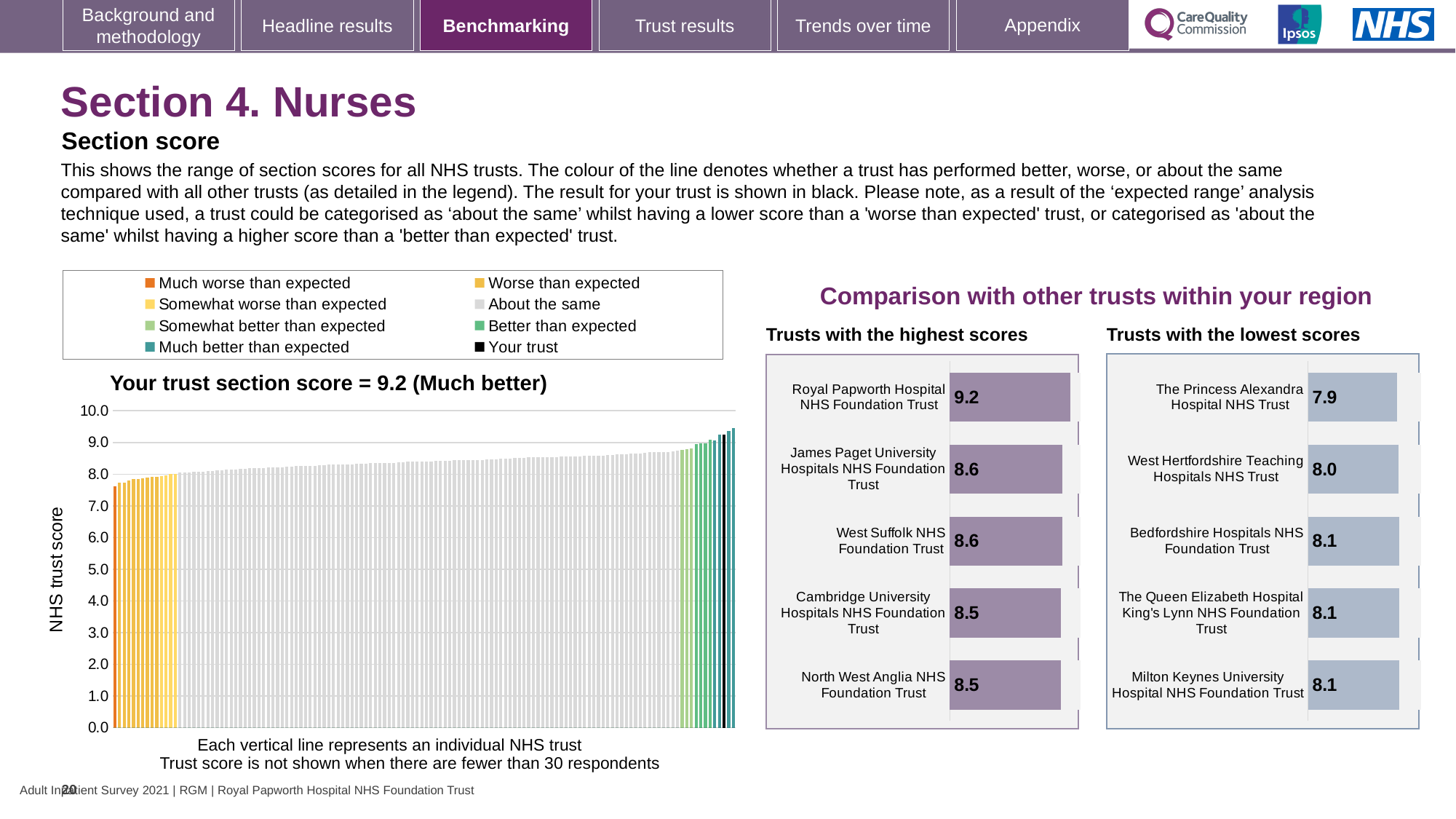
In the 'Trusts with the highest scores' chart, which has the larger score: James Paget University Hospitals NHS Foundation Trust or Cambridge University Hospitals NHS Foundation Trust? James Paget University Hospitals NHS Foundation Trust In the 'Trusts with the highest scores' chart, what is the score for Royal Papworth Hospital NHS Foundation Trust? 9.2 How many trusts are shown in the 'Trusts with the highest scores' chart? 5 In the 'Trusts with the lowest scores' chart, what is the score for The Princess Alexandra Hospital NHS Trust? 7.9 How many entries does the legend of the main chart on the left list? 8 In the 'Trusts with the highest scores' chart, which trust has the highest score? Royal Papworth Hospital NHS Foundation Trust In the main chart on the left, is the value for the lowest-scoring trust (the leftmost bar) greater or less than 8.0? less In the 'Trusts with the lowest scores' chart, which trust has the lowest score? The Princess Alexandra Hospital NHS Trust In the 'Trusts with the lowest scores' chart, what is the difference between the scores of West Hertfordshire Teaching Hospitals NHS Trust and The Princess Alexandra Hospital NHS Trust? 0.1 What kind of chart is the main chart on the left showing the range of section scores for all NHS trusts? Bar chart In the 'Trusts with the highest scores' chart, what is the difference between the scores of Royal Papworth Hospital NHS Foundation Trust and James Paget University Hospitals NHS Foundation Trust? 0.6 According to the main chart on the left, what is your trust's section score? 9.2